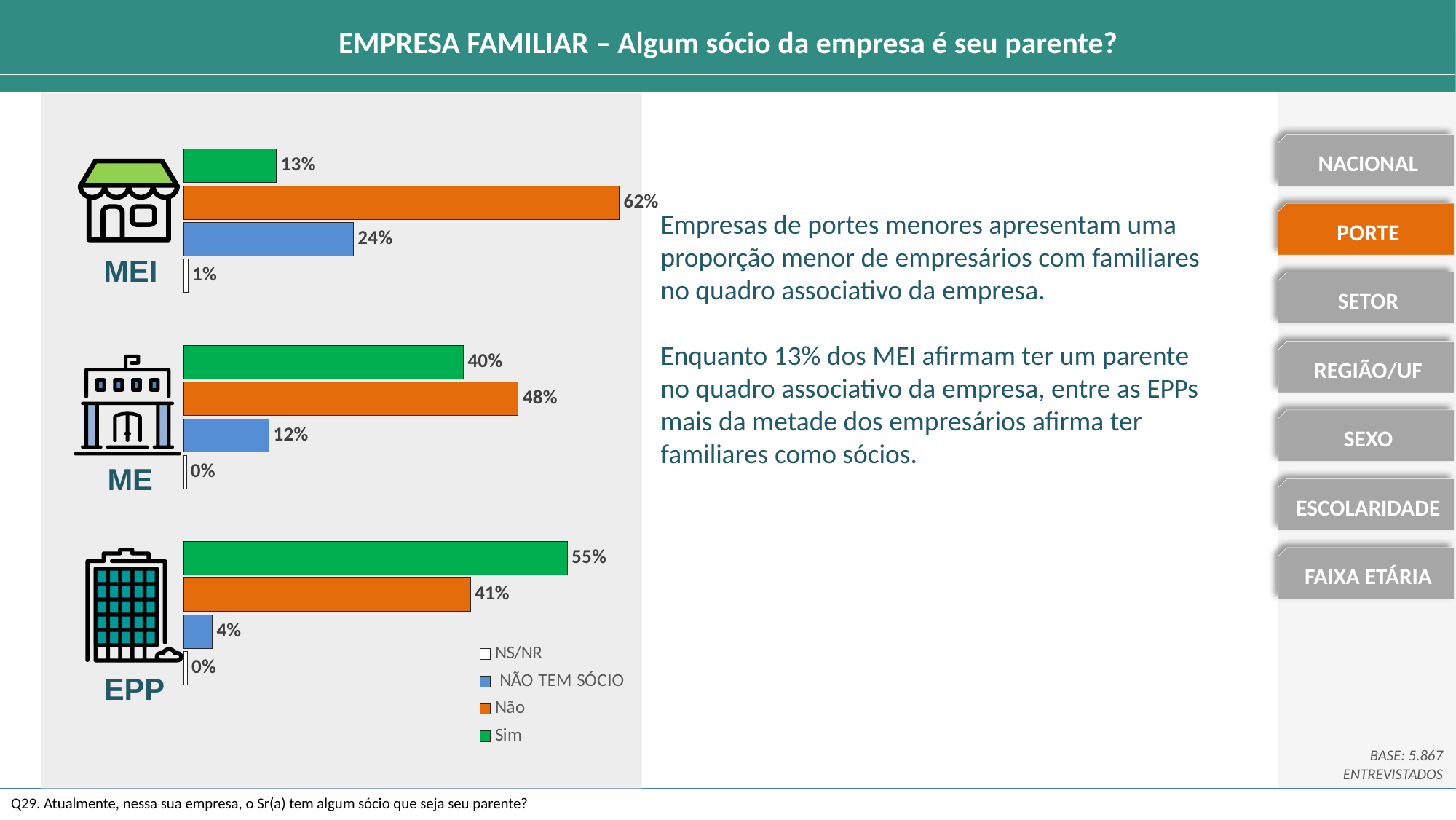
What is the value of "Não" for MEI? 62% Which colour represents "Sim" in the chart? Green For ME, which is larger: "Sim" or "Não"? Não What is the difference between the "Não" value for MEI and the "Não" value for EPP? 21% How many company size categories are shown in the chart? 3 Which company size has the lowest "NÃO TEM SÓCIO" value? EPP What is the value of "NÃO TEM SÓCIO" for ME? 12% Which company size (MEI, ME or EPP) has the highest "Sim" value? EPP What percentage of EPP respondents answered "Sim"? 55% How many series does the legend list? 4 What type of chart is shown on the slide? Bar chart What percentage of MEI respondents answered "Sim"? 13%